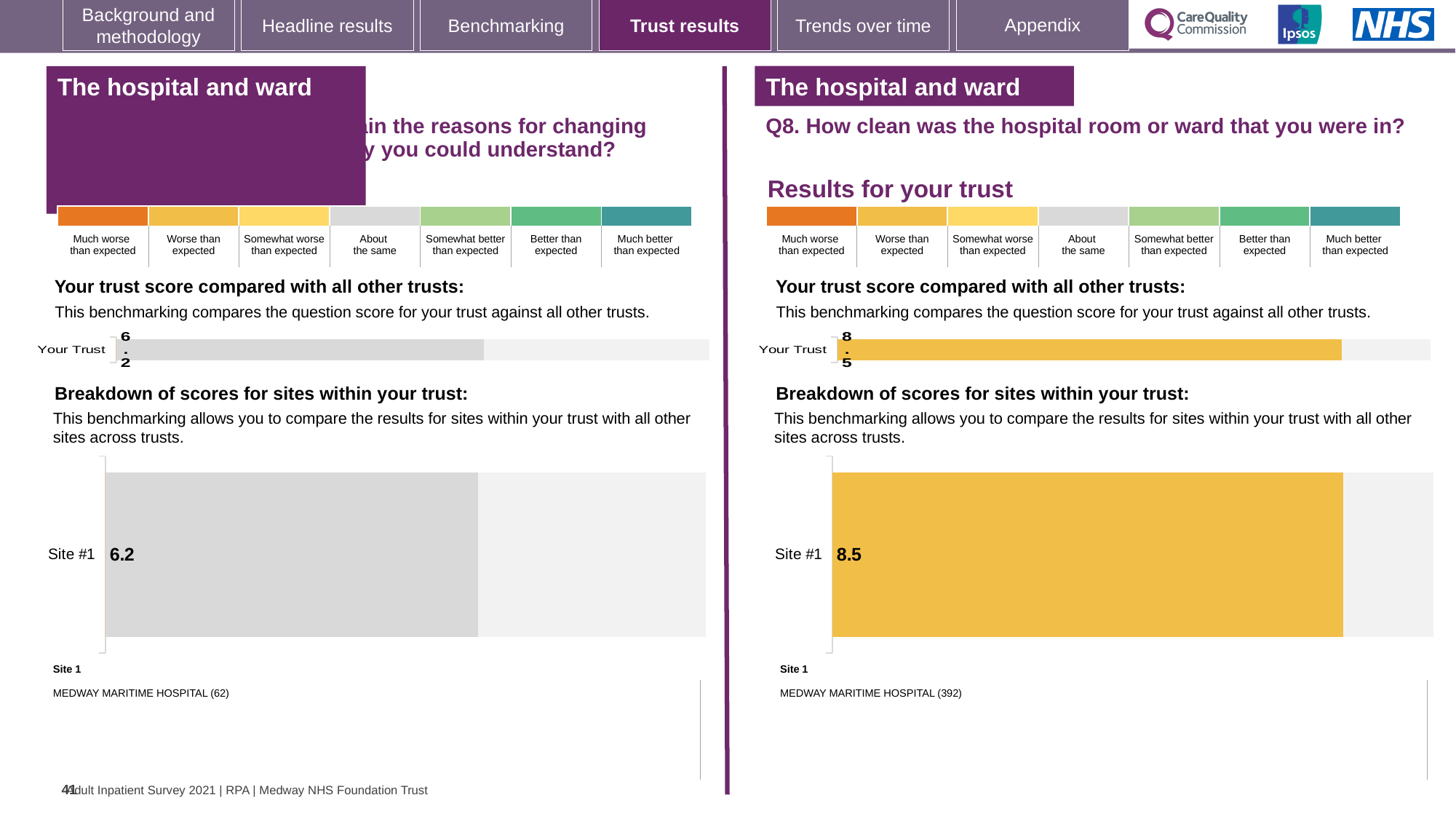
According to the colour key, which benchmarking category does the yellow colour of the Site #1 bar on the right-hand Q8 chart represent? Worse than expected Which is larger: the Your Trust score on the left-hand chart or the Your Trust score on the right-hand Q8 chart? The right-hand Q8 chart On the left-hand chart (the question about reasons for changing wards), what is the score shown for Your Trust? 6.2 How many sites are shown in the site breakdown chart on the right-hand side for Q8? 1 On the right-hand site breakdown chart for Q8, what is the score for Site #1? 8.5 How many sites are shown in the site breakdown chart on the left-hand side? 1 On the left-hand site breakdown chart, what is the score for Site #1? 6.2 What type of chart is used to show the Your Trust score on the right-hand Q8 chart? Bar chart What type of chart is used for the site breakdown on the left-hand side? Bar chart On the right-hand chart for Q8 (How clean was the hospital room or ward), what is the score shown for Your Trust? 8.5 According to the colour key, which benchmarking category does the grey colour of the Site #1 bar on the left-hand chart represent? About the same What is the difference between the Site #1 score on the right-hand Q8 chart and the Site #1 score on the left-hand chart? 2.3